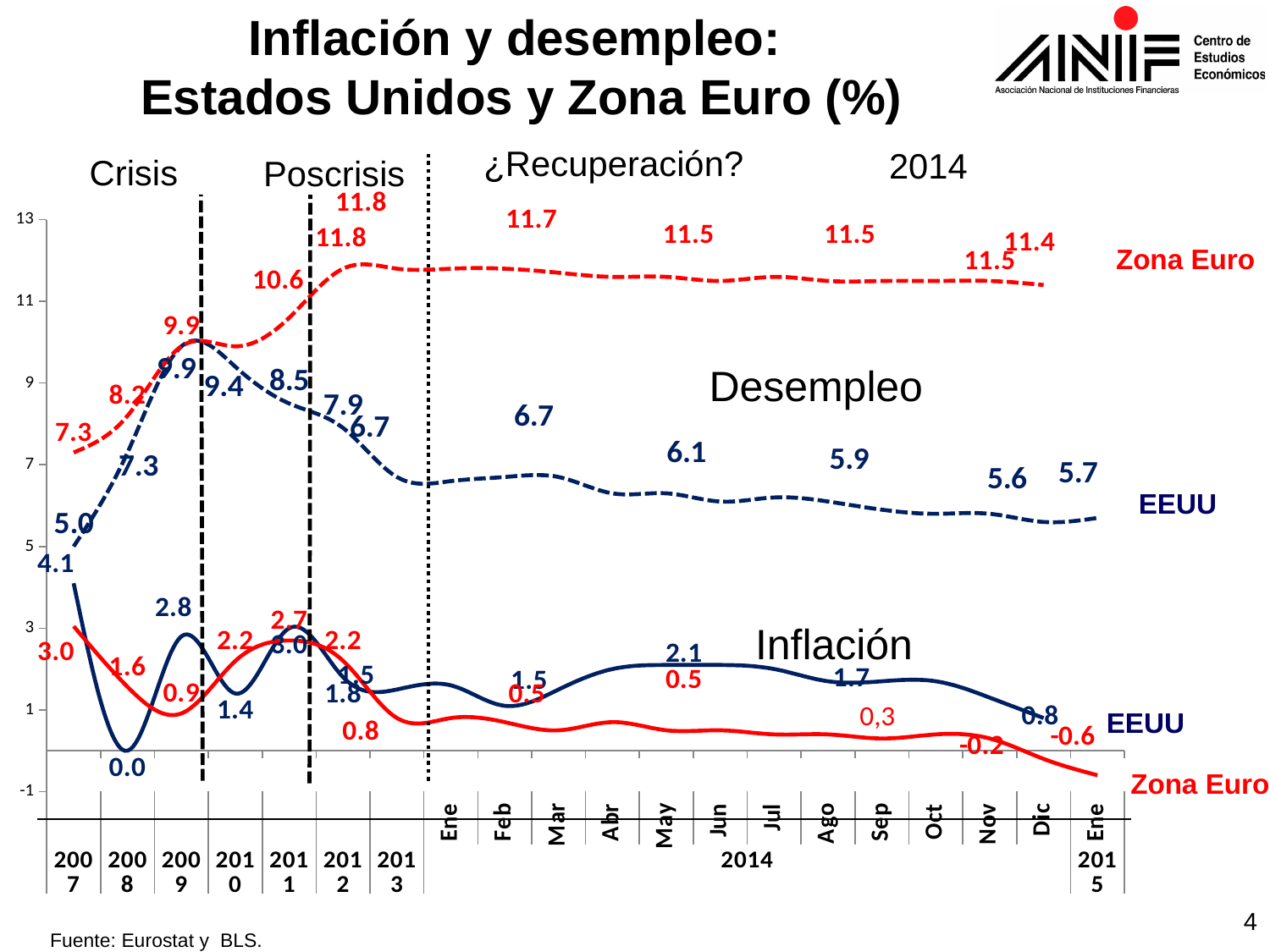
What is the last labelled value of the EEUU unemployment (Desempleo) line, at Ene 2015? 5.7 What is the Zona Euro inflation (Inflación) value labelled for 2011? 2.7 What source is cited at the bottom of the slide? Eurostat y BLS What is the EEUU inflation (Inflación) value labelled for 2008? 0.0 Is the Zona Euro unemployment value in 2014 greater or less than 11? greater What is the EEUU unemployment (Desempleo) value labelled for 2009? 9.9 Does the EEUU unemployment (Desempleo) line rise or fall from 2009 to Ene 2015? Fall What is the difference between Zona Euro unemployment (11.8) and EEUU unemployment (6.7) in 2013? 5.1 What kind of chart is shown on the slide? Line chart What is the last labelled value of the Zona Euro inflation (Inflación) line, at Ene 2015? -0.6 What is the Zona Euro unemployment (Desempleo) value labelled for 2007? 7.3 Which is higher in 2013: Zona Euro unemployment (11.8) or EEUU unemployment (6.7)? Zona Euro